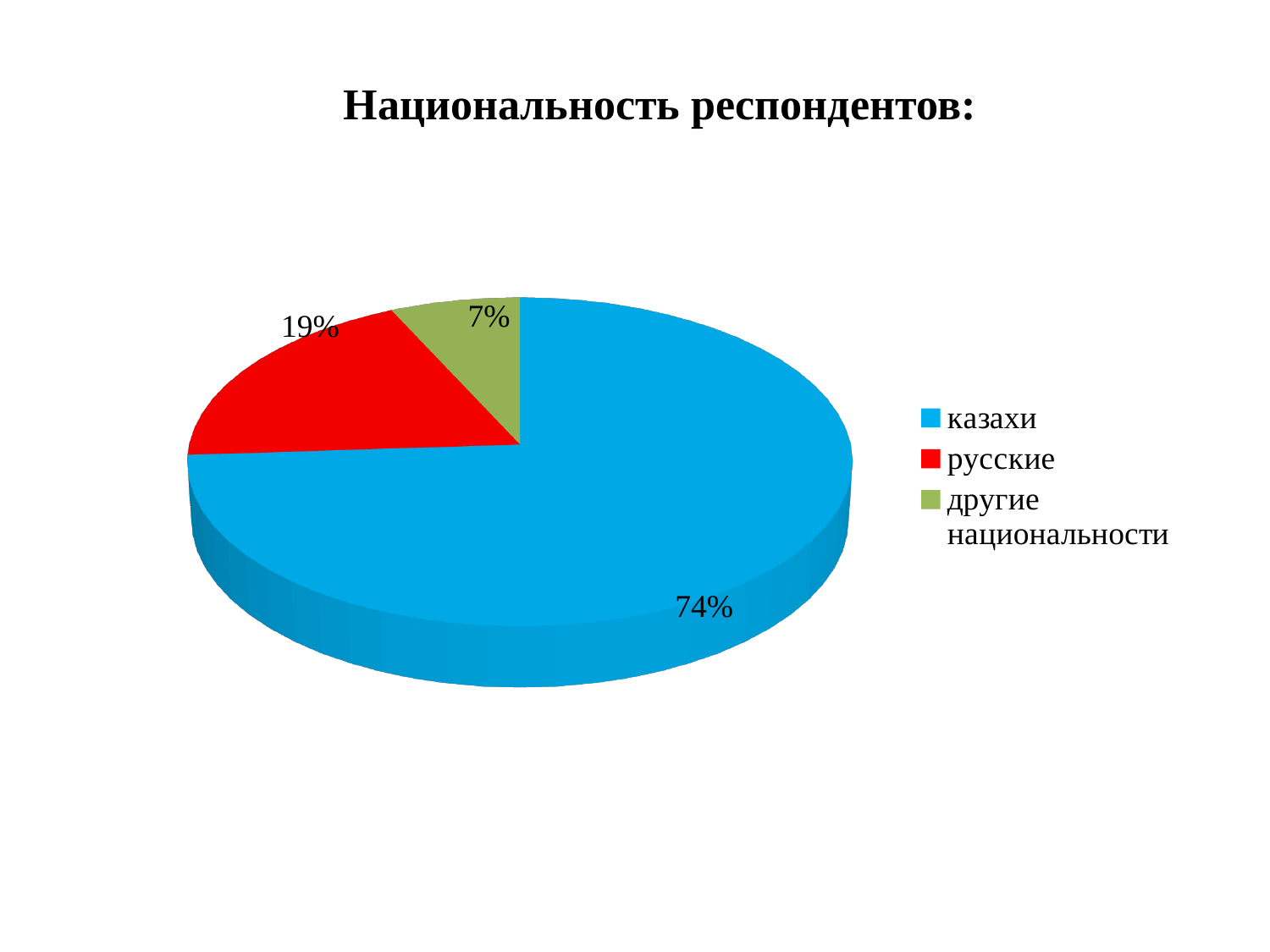
What share of respondents are русские? 19% What is the difference in percentage points between the казахи and русские shares? 55 What share of respondents are другие национальности? 7% Which nationality group has the largest share of respondents? казахи Which nationality group has the smallest share of respondents? другие национальности Which share is larger, русские or другие национальности? русские What colour is the slice for русские? red What is the title of the chart? Национальность респондентов: What is the difference in percentage points between the русские and другие национальности shares? 12 What share of respondents are казахи? 74% What kind of chart is shown on the slide? pie chart How many slices does the pie chart have? 3